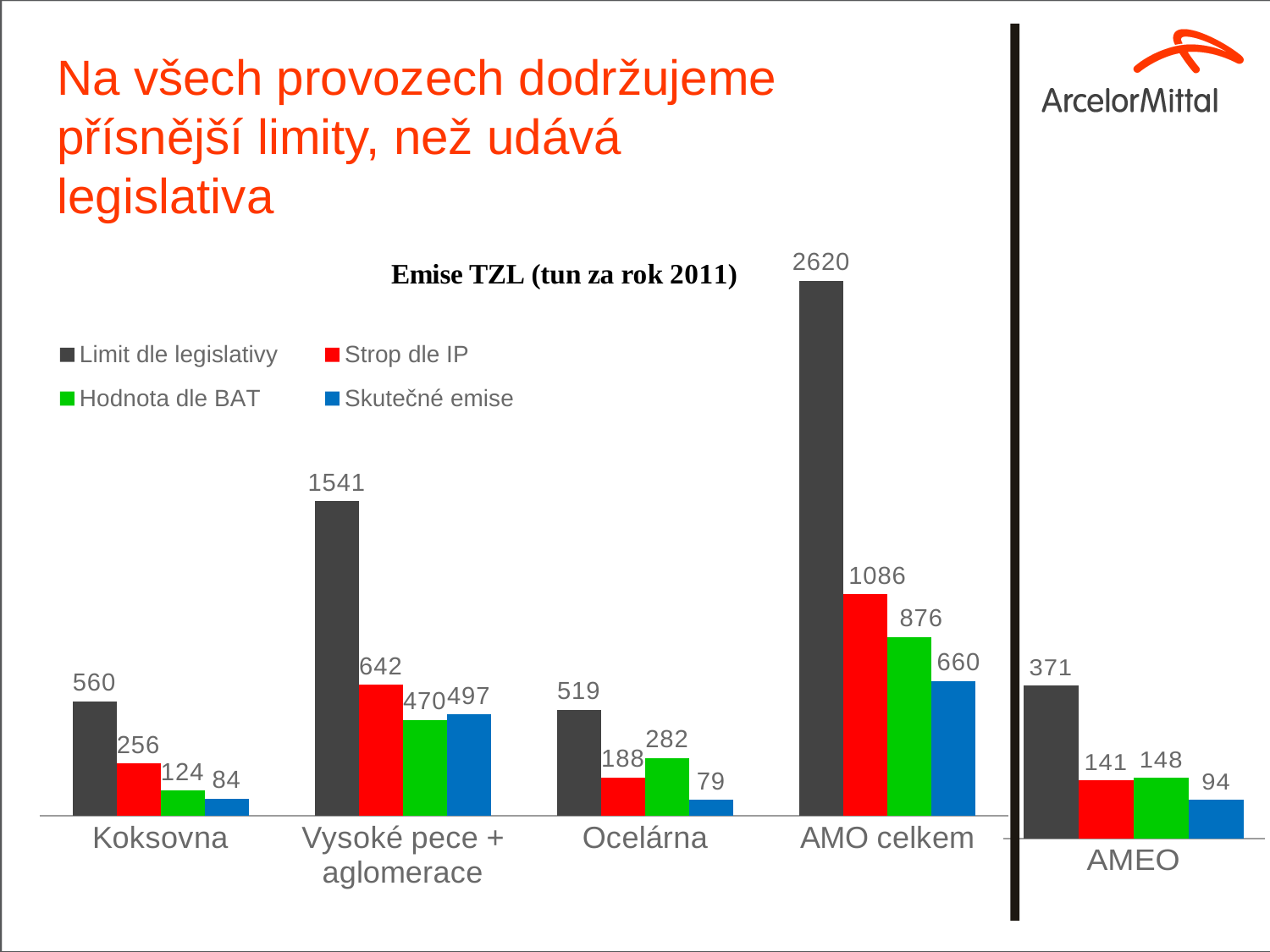
What is the value of Skutečné emise for Ocelárna? 79 For Vysoké pece + aglomerace, which is larger: Hodnota dle BAT or Skutečné emise? Skutečné emise Which category has the highest value for Limit dle legislativy? AMO celkem What is the value of Limit dle legislativy for Koksovna? 560 What is the value of Strop dle IP for AMO celkem? 1086 What is the difference between Limit dle legislativy and Skutečné emise for Vysoké pece + aglomerace? 1044 How many series does the legend list? 4 What kind of chart is shown on the slide? Bar chart What is the difference between Strop dle IP and Hodnota dle BAT for AMO celkem? 210 For Ocelárna, which is larger: Strop dle IP or Hodnota dle BAT? Hodnota dle BAT What is the value of Hodnota dle BAT for AMEO? 148 Which category has the lowest value for Skutečné emise? Ocelárna